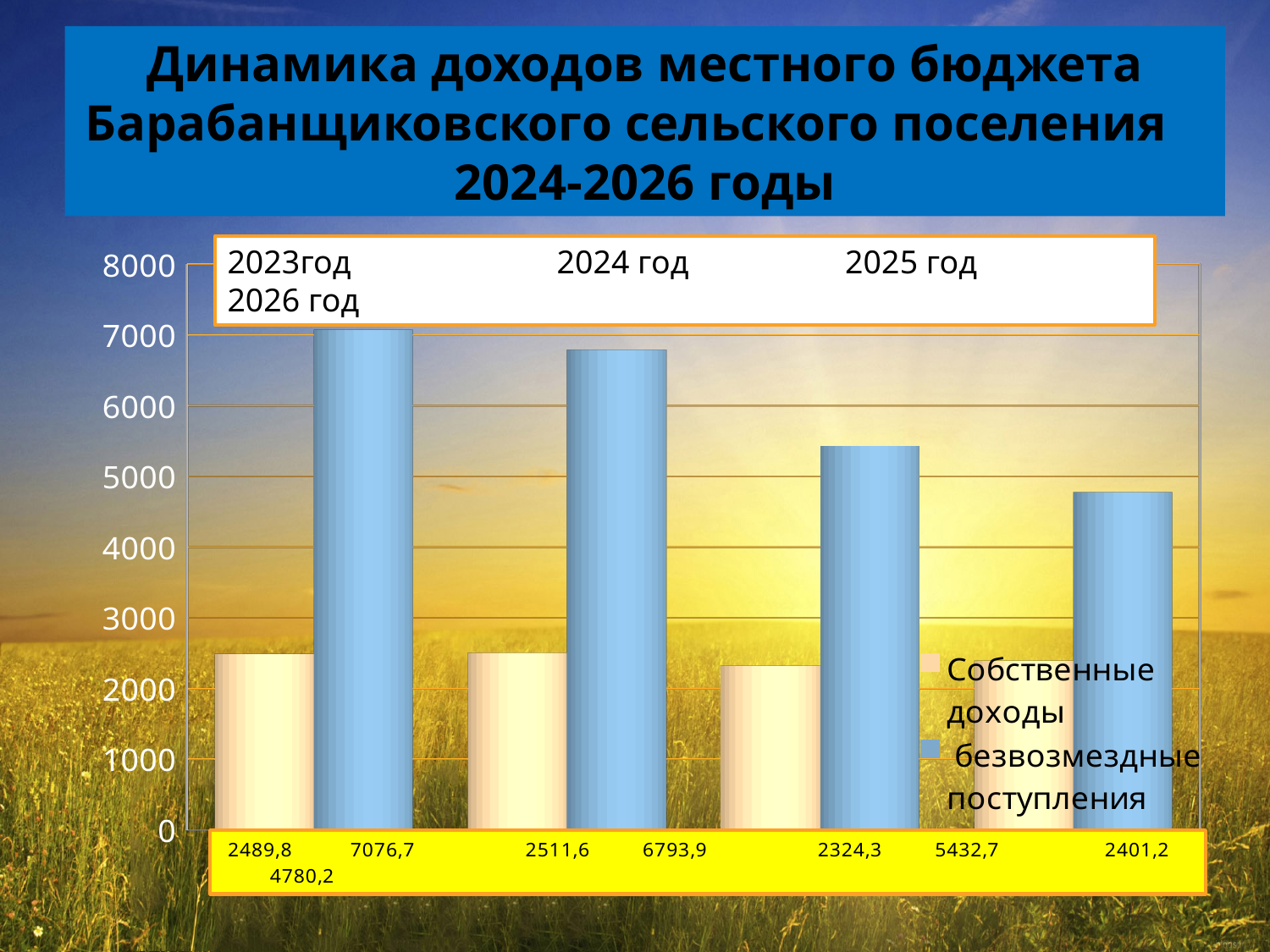
What is the value of Собственные доходы for 2025 год? 2324,3 Do безвозмездные поступления rise or fall from 2023 год to 2026 год? fall What is the difference between безвозмездные поступления in 2024 год and 2025 год? 1361,2 Which is larger: Собственные доходы in 2023 год or in 2026 год? 2023 год How many year categories are shown on the chart? 4 What is the value of безвозмездные поступления for 2026 год? 4780,2 What is the value of безвозмездные поступления for 2023 год? 7076,7 In which year are безвозмездные поступления the highest? 2023 год What is the value of Собственные доходы for 2024 год? 2511,6 How many series does the legend list? 2 What type of chart is shown on the slide? bar chart In which year are Собственные доходы the lowest? 2025 год